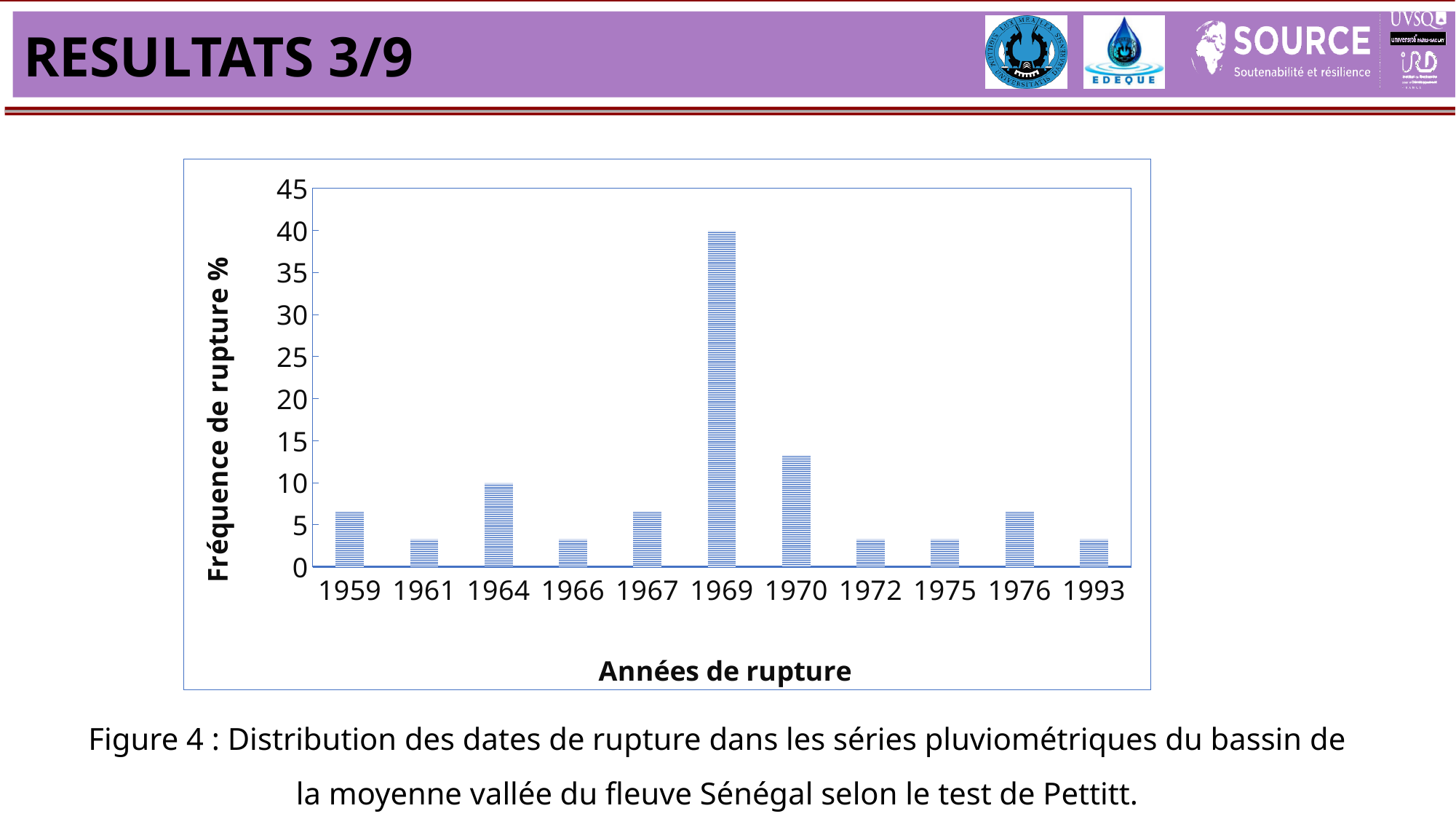
What kind of chart is shown on the slide? bar chart Is the value for 1970 greater or less than 15? less Is the value for 1969 greater or less than 35? greater Is the value for 1970 greater or less than 10? greater Which year has the highest rupture frequency? 1969 Which has the larger rupture frequency, 1964 or 1959? 1964 How many years of rupture are shown on the x axis? 11 Which has the larger rupture frequency, 1970 or 1964? 1970 What is the title of the x axis? Années de rupture What is the title of the y axis? Fréquence de rupture %